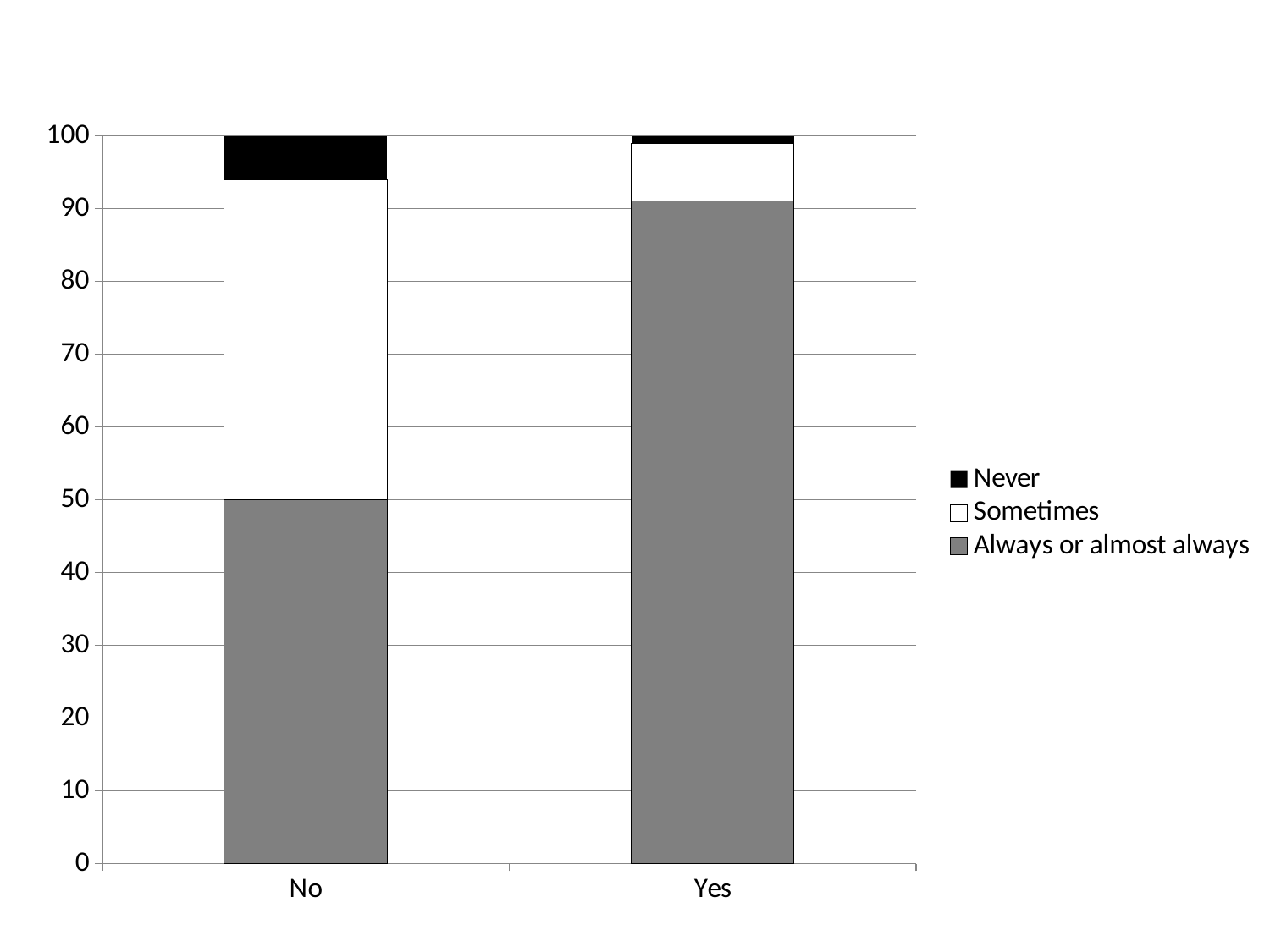
What colour represents the 'Never' series? black Is the 'Sometimes' segment for 'No' greater or less than 30? greater What are the three entries listed in the legend? Never, Sometimes, Always or almost always How many series does the legend list? 3 Which category has the larger 'Always or almost always' segment, 'No' or 'Yes'? Yes Is the 'Never' segment for 'Yes' greater or less than 10? less How many categories are shown on the x axis? 2 What kind of chart is shown on the slide? bar chart Is the 'Always or almost always' value for 'Yes' greater or less than 80? greater What is the value of the 'Always or almost always' segment for the 'No' category? 50 Which category has the larger 'Sometimes' segment, 'No' or 'Yes'? No